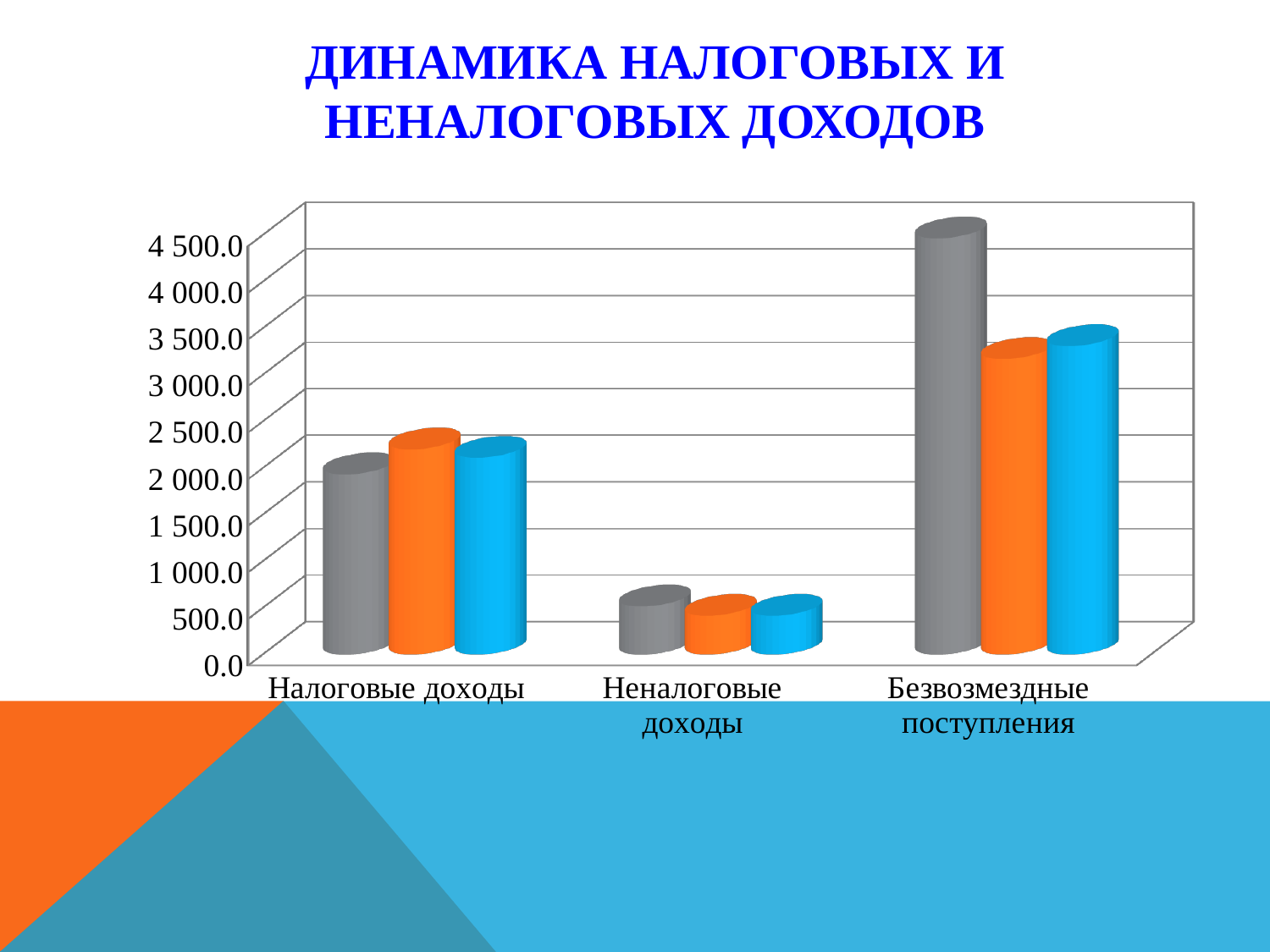
How many categories are shown on the x axis of the chart? 3 Is the orange bar for Налоговые доходы greater or less than 2 000.0? greater What is the title of the slide's chart? ДИНАМИКА НАЛОГОВЫХ И НЕНАЛОГОВЫХ ДОХОДОВ Is the grey bar for Безвозмездные поступления greater or less than 4 000.0? greater What kind of chart is shown on the slide? bar chart For Безвозмездные поступления, which is larger: the grey bar or the orange bar? the grey bar How many bars are plotted for each category in the chart? 3 Is the grey bar for Неналоговые доходы greater or less than 1 000.0? less Which category has the shortest bars in the chart? Неналоговые доходы Which category has the tallest bars in the chart? Безвозмездные поступления Which is larger: the grey bar for Безвозмездные поступления or the grey bar for Налоговые доходы? the grey bar for Безвозмездные поступления